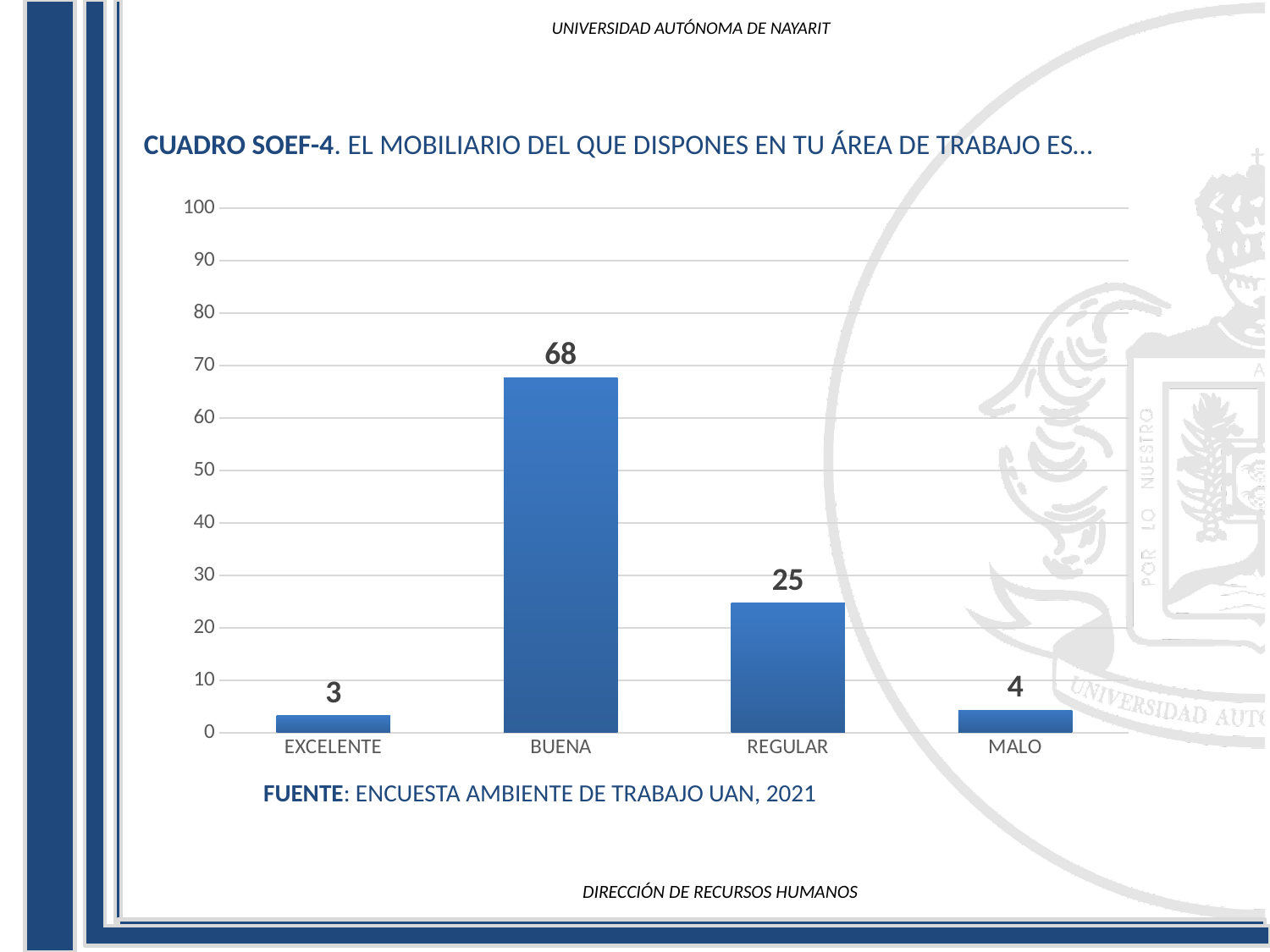
What is the difference between the values for BUENA and REGULAR? 43 Which is larger, the value for REGULAR or the value for MALO? REGULAR Which category has the highest value? BUENA What is the value for REGULAR? 25 What is the value for EXCELENTE? 3 What is the value for MALO? 4 How many categories are shown on the x axis? 4 Which category has the lowest value? EXCELENTE What source is cited below the chart? ENCUESTA AMBIENTE DE TRABAJO UAN, 2021 What is the value for BUENA? 68 What kind of chart is shown on the slide? bar chart Is the value for BUENA greater or less than 60? greater